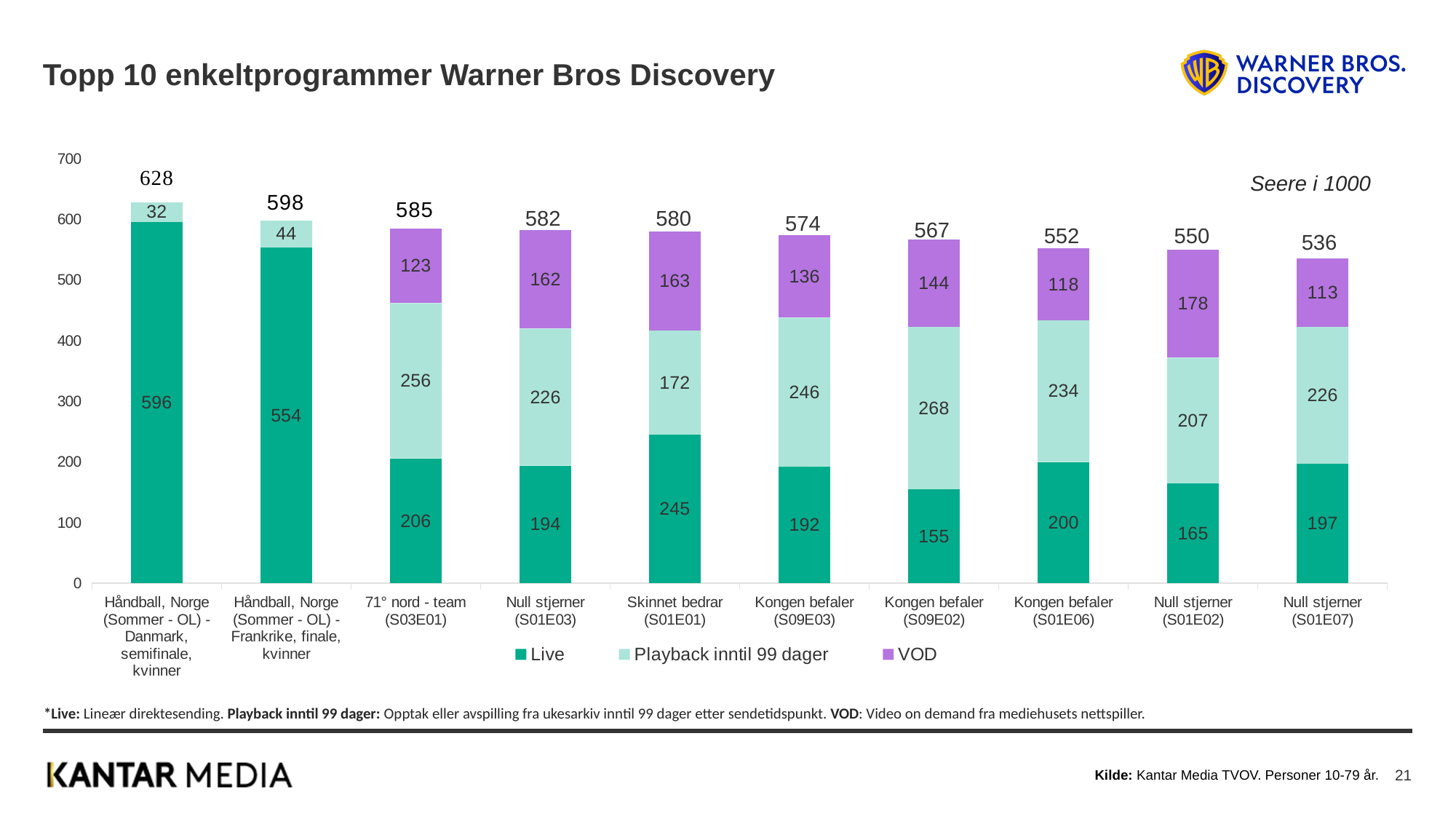
Which is larger: the Live value for Kongen befaler (S01E06) or the Live value for Kongen befaler (S09E02)? Kongen befaler (S01E06) How many series does the legend list? 3 What is the Live value for Skinnet bedrar (S01E01)? 245 What unit note is shown in the top right of the chart area? Seere i 1000 Which programme has the lowest total? Null stjerner (S01E07) How many programmes (categories) are shown on the x axis? 10 What type of chart is shown on the slide? Stacked bar chart What is the VOD value for Null stjerner (S01E02)? 178 Which programme has the highest total? Håndball, Norge (Sommer - OL) - Danmark, semifinale, kvinner What is the Playback inntil 99 dager value for Kongen befaler (S09E02)? 268 What is the difference between the totals of Null stjerner (S01E03) and Null stjerner (S01E07)? 46 What is the total for the bar 71° nord - team (S03E01)? 585